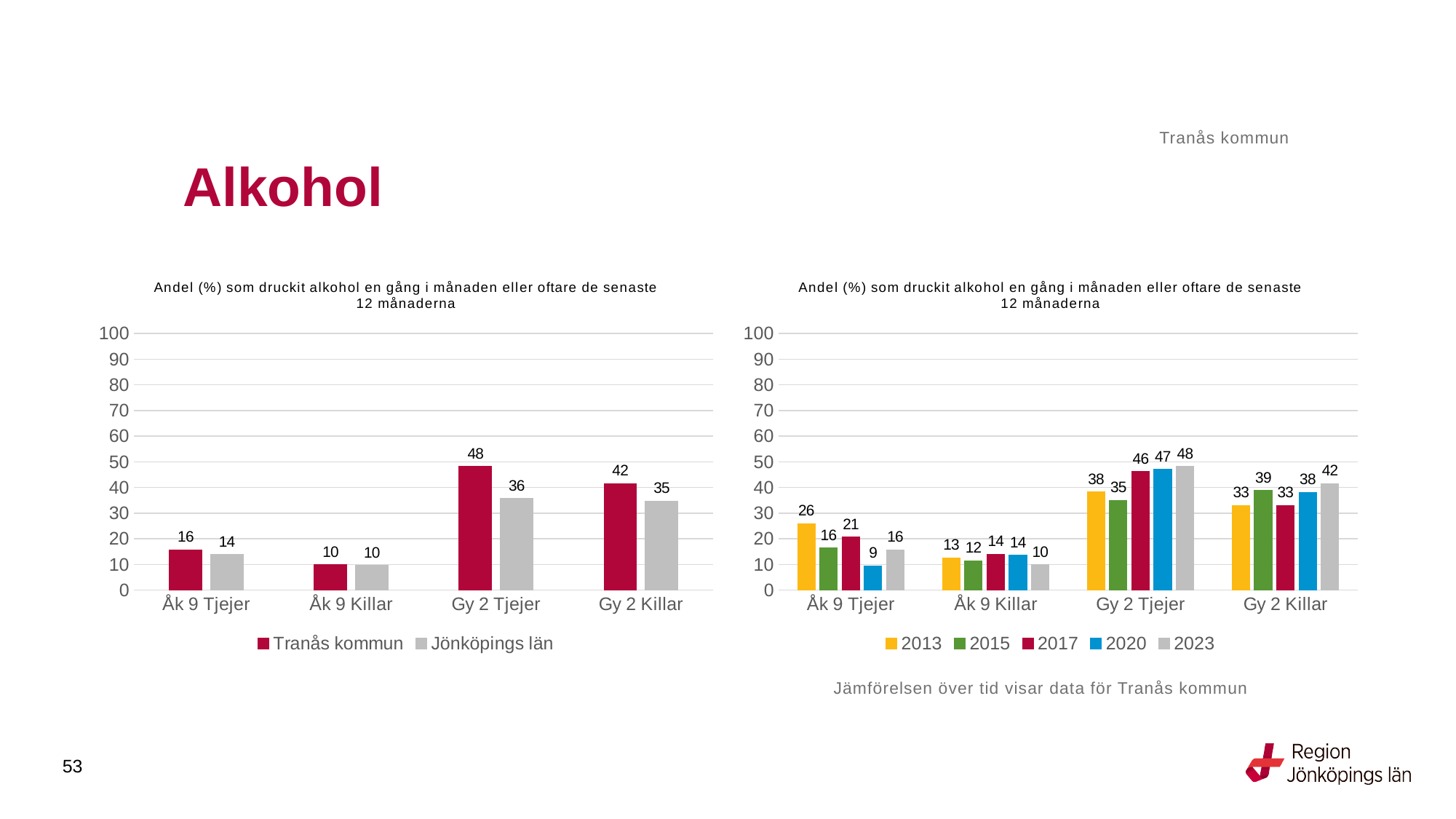
In the left chart, what is the value for Jönköpings län for Gy 2 Killar? 35 In the right chart, which year has the highest value for Gy 2 Tjejer? 2023 In the right chart, which is larger for Åk 9 Tjejer: 2017 or 2020? 2017 In the right chart, what is the value for 2023 for Gy 2 Killar? 42 In the left chart, what is the difference between Tranås kommun and Jönköpings län for Gy 2 Tjejer? 12 In the right chart, how many series does the legend list? 5 In the right chart, how many categories are shown on the x axis? 4 In the left chart, how many series does the legend list? 2 What kind of chart is the left chart? Bar chart In the left chart, which category has the lowest value for Tranås kommun? Åk 9 Killar In the right chart, what is the value for 2013 for Åk 9 Tjejer? 26 In the left chart, what is the value for Tranås kommun for Gy 2 Tjejer? 48